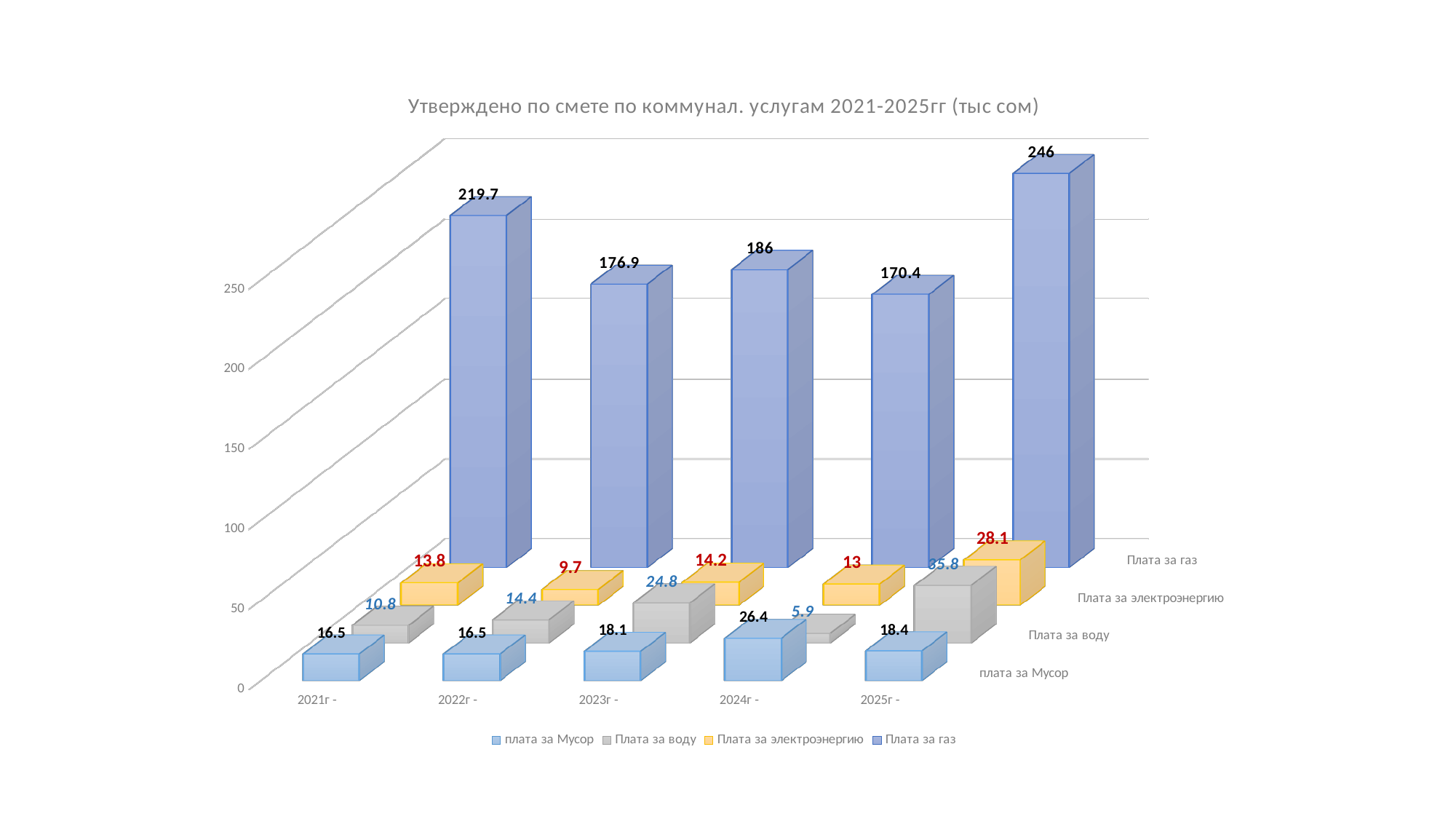
What kind of chart is shown on the slide? Bar chart In which year is Плата за воду lowest? 2024г What is the value for Плата за электроэнергию in 2022г? 9.7 Which is larger in 2023г: Плата за воду or Плата за электроэнергию? Плата за воду How many series does the legend list? 4 What is the value for плата за Мусор in 2024г? 26.4 How many years are shown on the x axis? 5 What is the value for Плата за воду in 2025г? 35.8 What is the difference between Плата за газ in 2025г and in 2024г? 75.6 In which year is Плата за газ highest? 2025г What is the value for Плата за газ in 2021г? 219.7 What is the title of the chart? Утверждено по смете по коммунал. услугам 2021-2025гг (тыс сом)